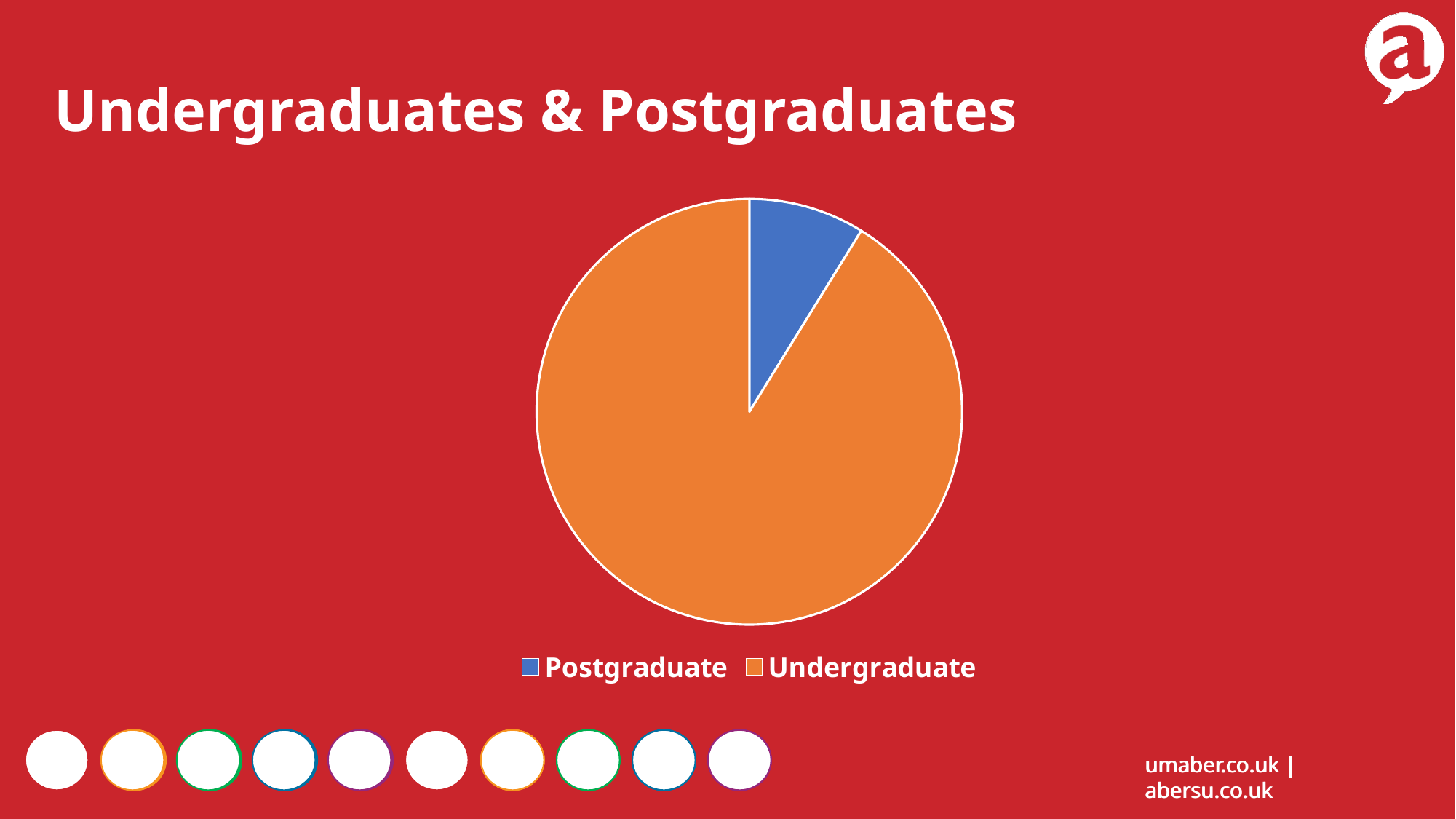
How many entries does the legend list? 2 What kind of chart is shown on the slide? pie chart What colour is the Undergraduate slice? orange Which category has the smallest slice of the pie chart? Postgraduate Which category has the largest slice of the pie chart? Undergraduate What colour is the Postgraduate slice? blue How many categories does the pie chart show? 2 Which slice is larger, Postgraduate or Undergraduate? Undergraduate